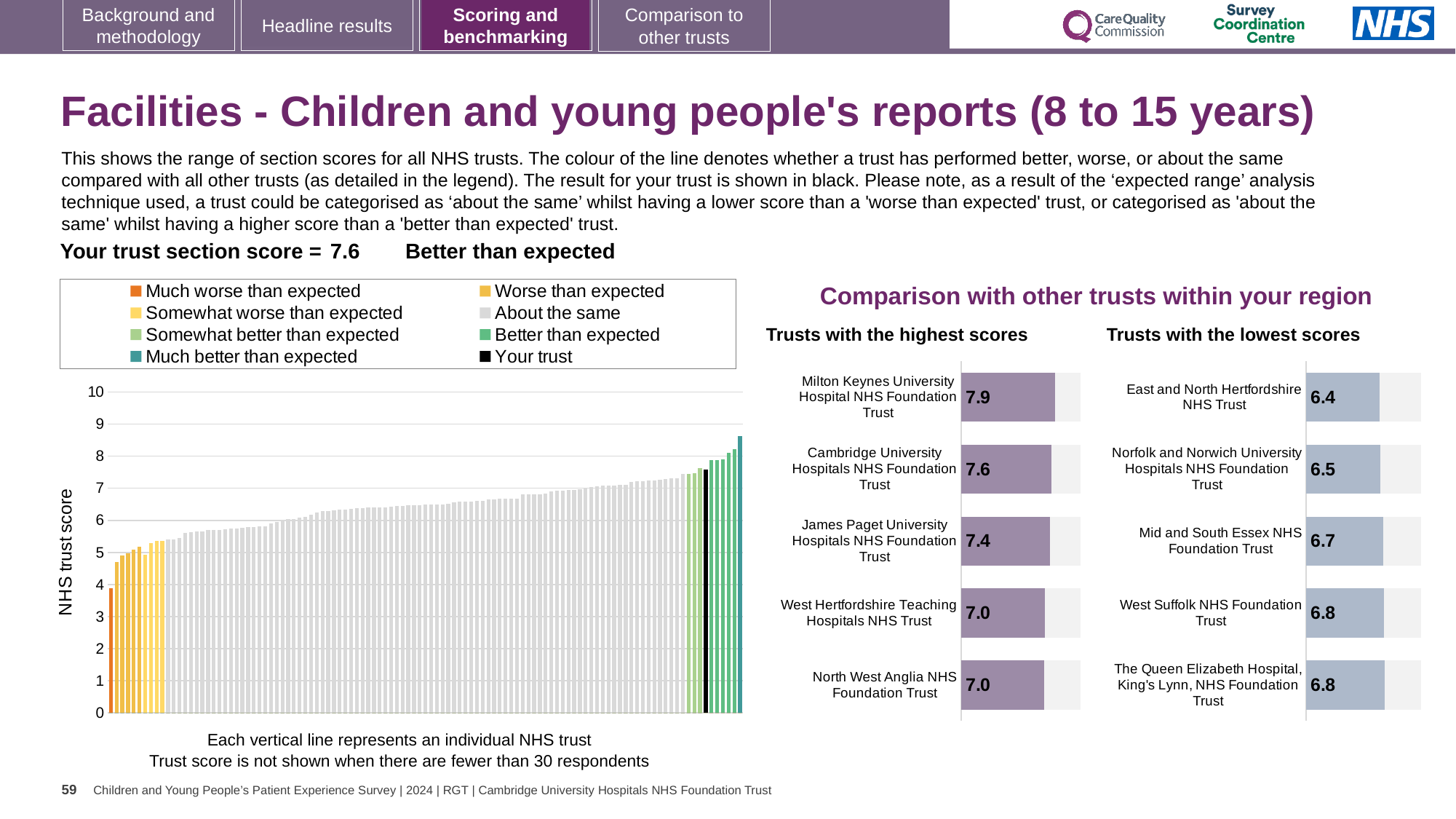
In the 'Trusts with the highest scores' chart, what is the difference between the scores of Milton Keynes University Hospital NHS Foundation Trust and North West Anglia NHS Foundation Trust? 0.9 In the 'Trusts with the highest scores' chart, how many trusts are listed? 5 In the 'Trusts with the lowest scores' chart, what is the score for Mid and South Essex NHS Foundation Trust? 6.7 In the large 'NHS trust score' chart on the left, is the value of the tallest bar greater or less than 8? greater How many entries does the legend of the large 'NHS trust score' chart on the left list? 8 In the 'Trusts with the highest scores' chart, which trust has the highest score? Milton Keynes University Hospital NHS Foundation Trust In the 'Trusts with the lowest scores' chart, what is the difference between the scores of West Suffolk NHS Foundation Trust and East and North Hertfordshire NHS Trust? 0.4 What kind of chart is the large chart on the left with the 'NHS trust score' axis? Bar chart In the large 'NHS trust score' chart on the left, do the bar values rise or fall from left to right? Rise In the 'Trusts with the lowest scores' chart, which trust has the lowest score? East and North Hertfordshire NHS Trust In the 'Trusts with the highest scores' chart, what is the score for Milton Keynes University Hospital NHS Foundation Trust? 7.9 In the 'Trusts with the highest scores' chart, which has the larger score: Cambridge University Hospitals NHS Foundation Trust or James Paget University Hospitals NHS Foundation Trust? Cambridge University Hospitals NHS Foundation Trust